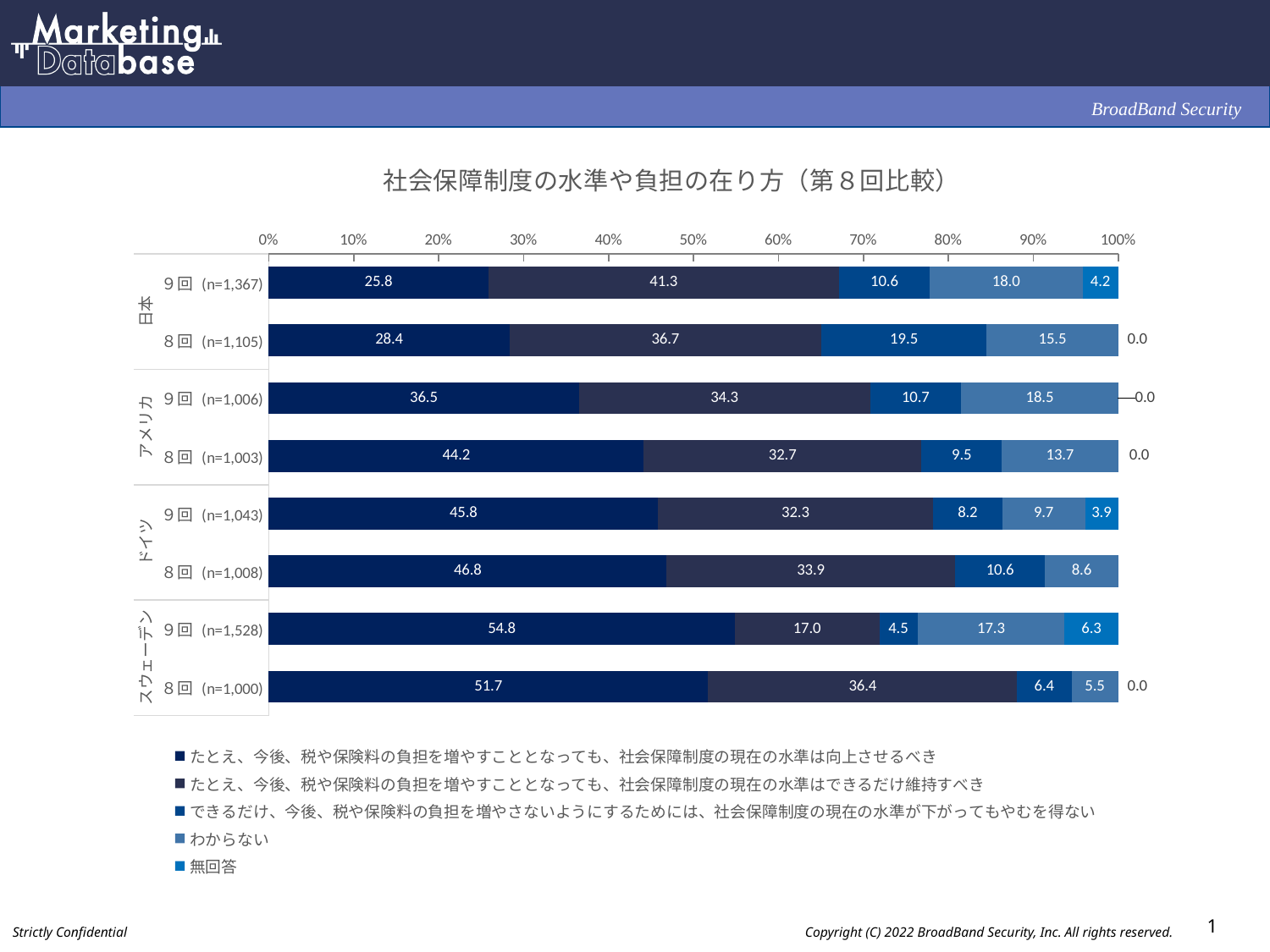
Which is larger: the second segment (できるだけ維持すべき) for スウェーデン 8回 (n=1,000) or for スウェーデン 9回 (n=1,528)? スウェーデン 8回 (n=1,000) What type of chart is shown on the slide? Stacked bar chart Which bar has the highest value for the first segment (向上させるべき)? スウェーデン 9回 (n=1,528) What is the title of the chart? 社会保障制度の水準や負担の在り方（第８回比較） What is the difference between the first-segment values of アメリカ 8回 (n=1,003) and アメリカ 9回 (n=1,006)? 7.7 What is the value of the second segment (できるだけ維持すべき) for 日本 9回 (n=1,367)? 41.3 Which bar has the lowest value for the first segment (向上させるべき)? 日本 9回 (n=1,367) What is the value of the first segment (向上させるべき) for スウェーデン 9回 (n=1,528)? 54.8 How many series does the legend list? 5 What is the value of the 無回答 segment for ドイツ 9回 (n=1,043)? 3.9 How many bars (survey rounds across countries) are plotted in the chart? 8 What is the value of the わからない segment for アメリカ 9回 (n=1,006)? 18.5